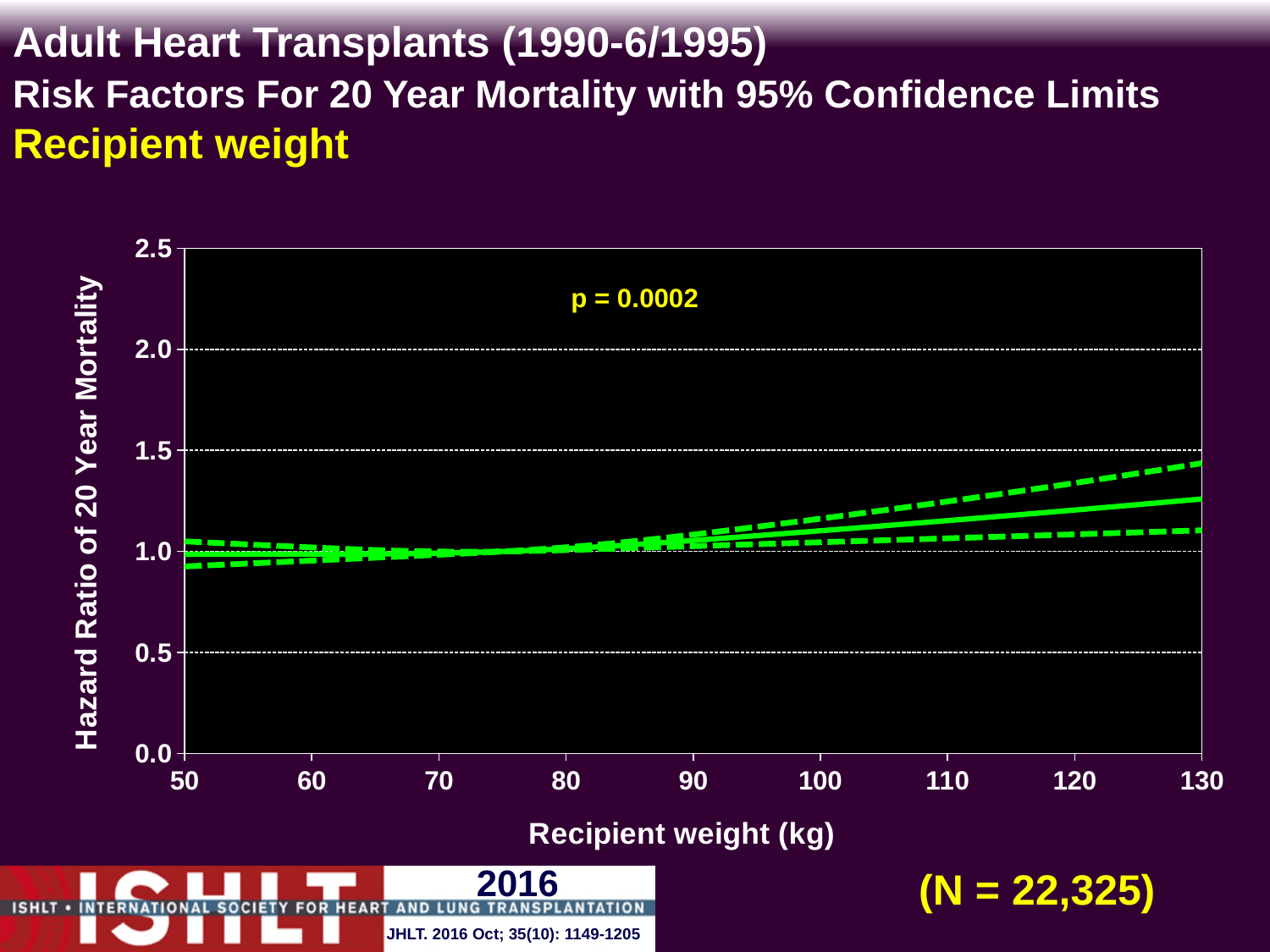
What is the highest value labelled on the y axis? 2.5 Is the value of the solid hazard ratio line at 50 kg greater or less than 0.5? greater How many lines are plotted on the chart? 3 What kind of chart is shown on the slide? line chart What p-value is printed on the chart? p = 0.0002 Is the value of the solid hazard ratio line at 130 kg greater or less than 1.0? greater Does the solid hazard ratio line rise or fall as recipient weight increases from 80 kg to 130 kg? rises Is the lower dashed confidence limit at 50 kg greater or less than 1.0? less How many tick labels are shown on the x axis? 9